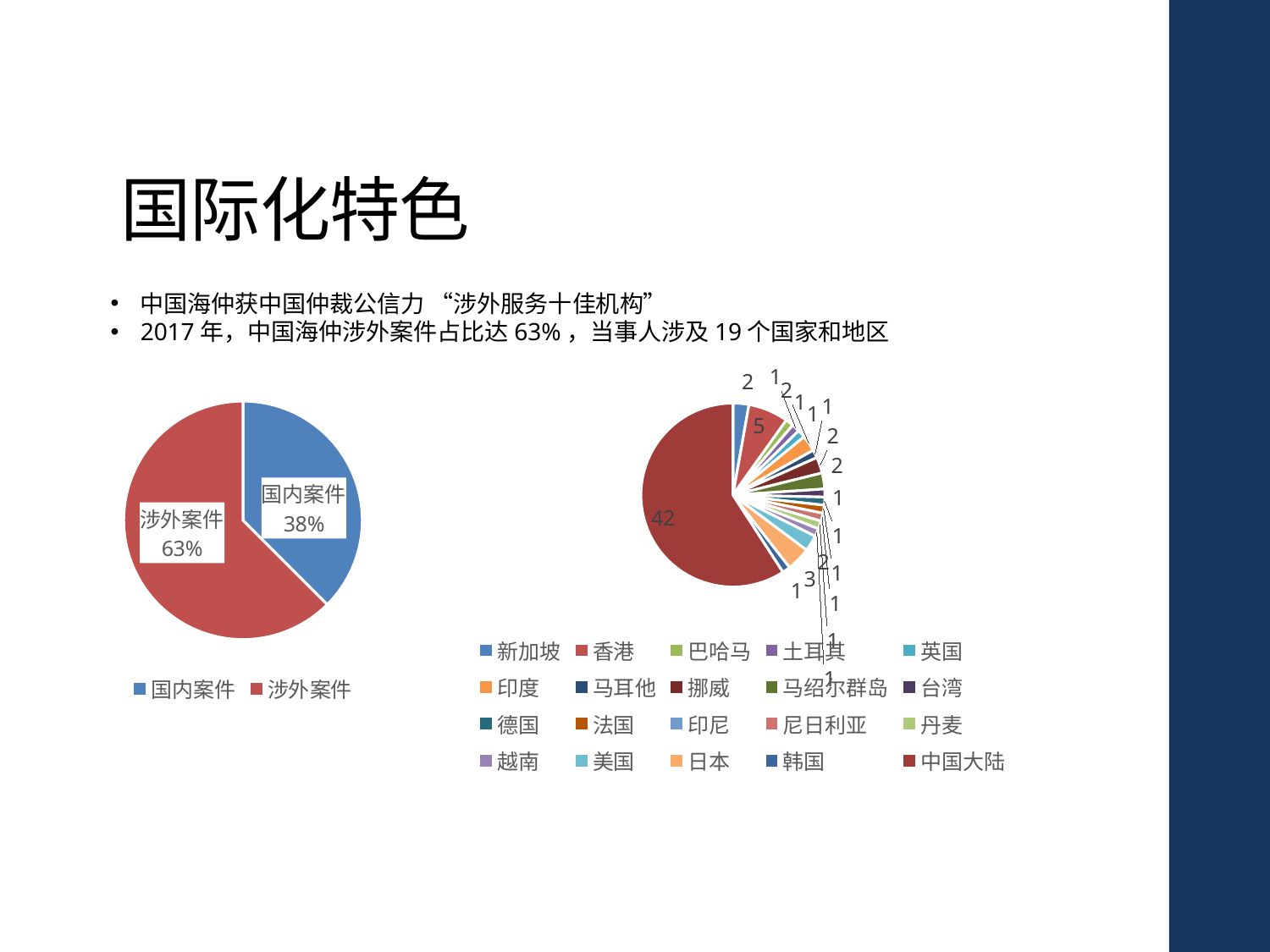
How many categories does the left pie chart's legend list? 2 In the right pie chart, which has the larger value, 香港 or 新加坡? 香港 In the right pie chart, what is the difference between the values for 中国大陆 and 香港? 37 In the right pie chart, which category has the largest slice? 中国大陆 In the right pie chart, what is the value shown for 新加坡? 2 In the right pie chart, what is the value shown for 香港? 5 In the left pie chart, what is the value shown for 国内案件? 38% In the right pie chart, what is the value shown for 中国大陆? 42 What type of chart is the left chart on the slide? pie chart In the left pie chart, what is the value shown for 涉外案件? 63% In the left pie chart, which category has the larger share, 国内案件 or 涉外案件? 涉外案件 How many entries does the legend of the right pie chart list? 20